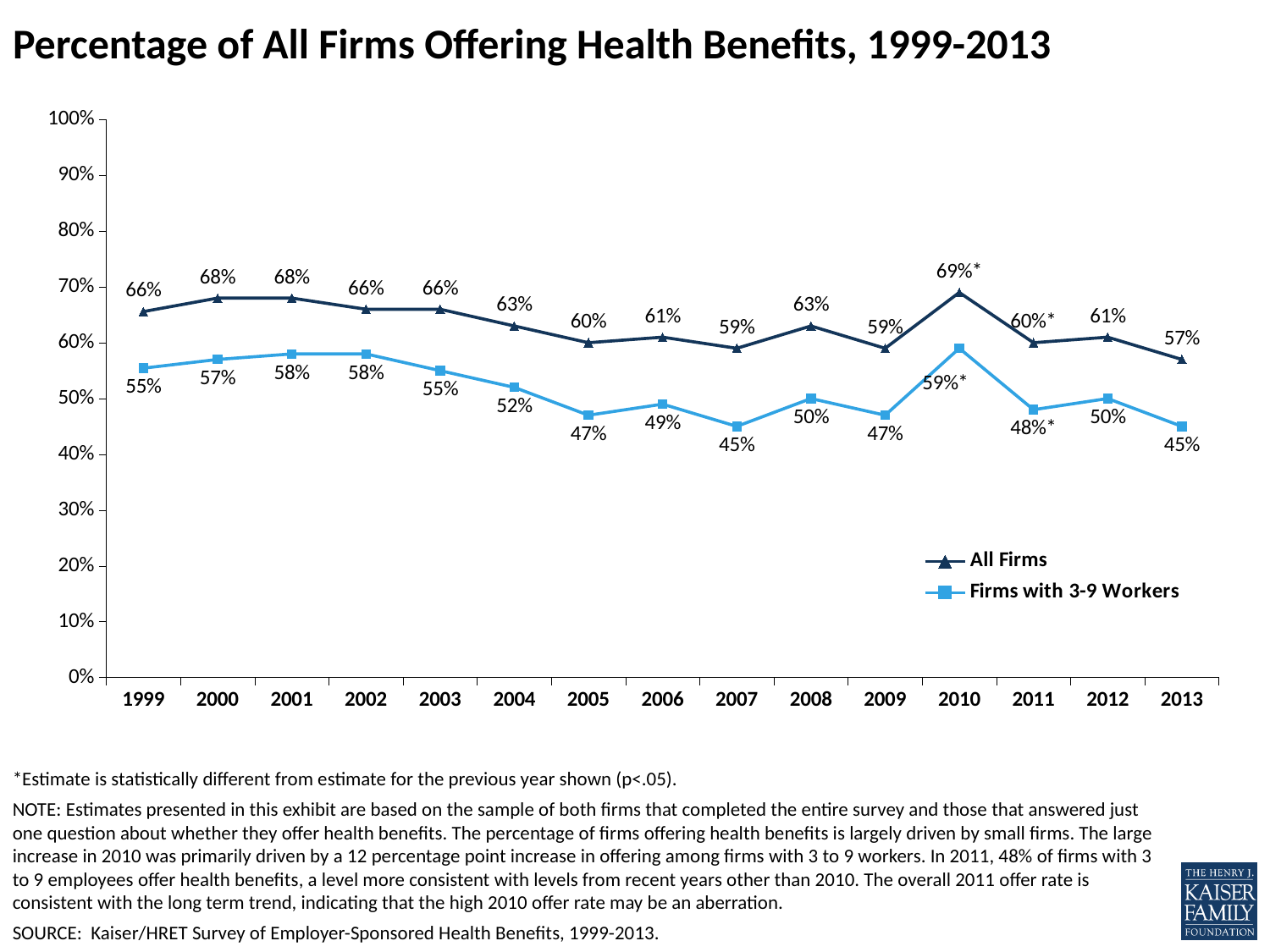
In which year is the value for Firms with 3-9 Workers highest? 2010 How many series does the legend list? 2 Overall, does the All Firms line rise or fall from 1999 to 2013? fall What percentage of Firms with 3-9 Workers offered health benefits in 2007? 45% What is the difference between All Firms and Firms with 3-9 Workers in 2013? 12 percentage points What type of chart is shown on the slide? line chart In which year is the All Firms value lowest? 2013 In which year is the All Firms value highest? 2010 What is the value for All Firms in 2013? 57% Which series has the higher value in 2005, All Firms or Firms with 3-9 Workers? All Firms What percentage of All Firms offered health benefits in 1999? 66% How many years are plotted along the x axis? 15